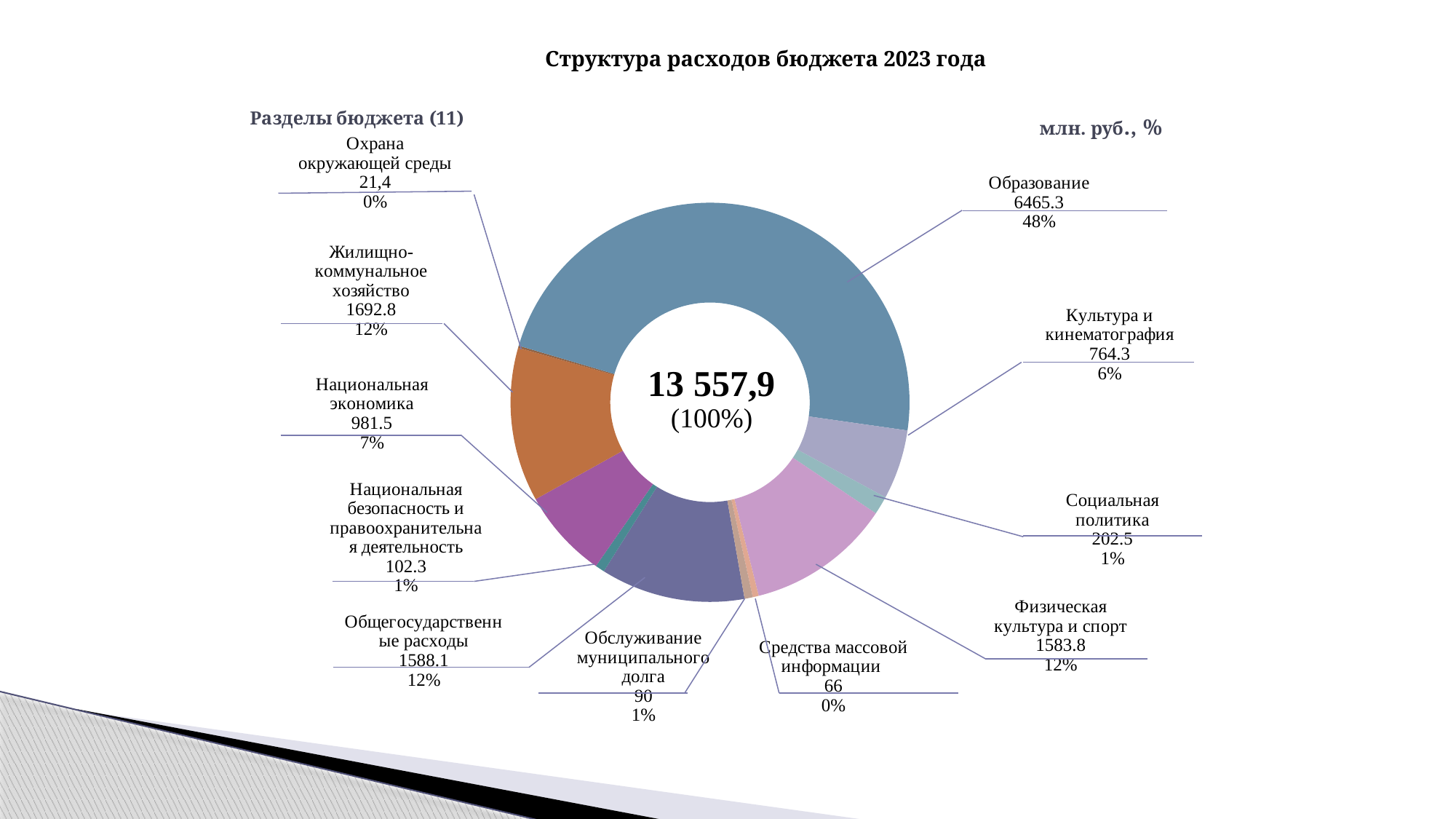
What share of the budget does Образование account for? 48% How many budget sections are shown in the chart? 11 What type of chart is shown on the slide? Doughnut (pie) chart What is the title of the chart? Разделы бюджета (11) Which budget section has the largest value? Образование Which is larger: Национальная экономика or Культура и кинематография? Национальная экономика What is the total shown in the centre of the chart? 13 557,9 Which budget section has the smallest value? Охрана окружающей среды What is the value for Образование in the chart? 6465.3 What is the value for Охрана окружающей среды? 21,4 What is the difference between Общегосударственные расходы (1588.1) and Физическая культура и спорт (1583.8)? 4.3 What is the value for Жилищно-коммунальное хозяйство? 1692.8